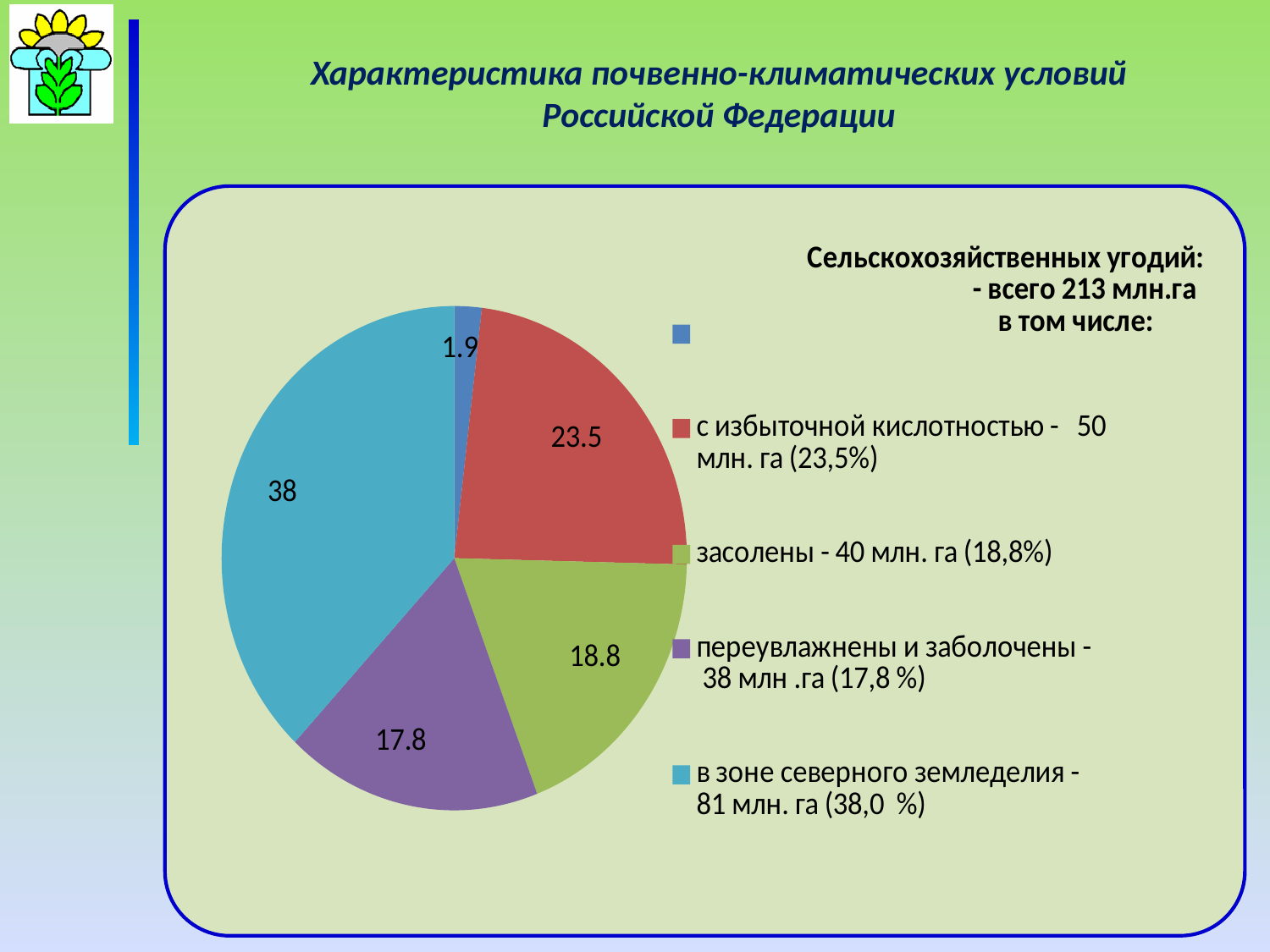
What value is shown for the slice "засолены"? 18.8 What is the difference between the values for "в зоне северного земледелия" and "с избыточной кислотностью"? 14.5 Which is larger: the slice for "засолены" or the slice for "переувлажнены и заболочены"? засолены What value is shown for the slice "с избыточной кислотностью"? 23.5 Which slice of the pie chart is the largest? в зоне северного земледелия According to the legend, how many million hectares are in the zone of northern agriculture ("в зоне северного земледелия")? 81 млн. га What kind of chart is shown on the slide? pie chart How many slices does the pie chart have? 5 What is the value of the smallest slice in the pie chart? 1.9 What colour is the slice for "с избыточной кислотностью"? red What value is shown for the slice "переувлажнены и заболочены"? 17.8 What value is shown for the slice "в зоне северного земледелия"? 38